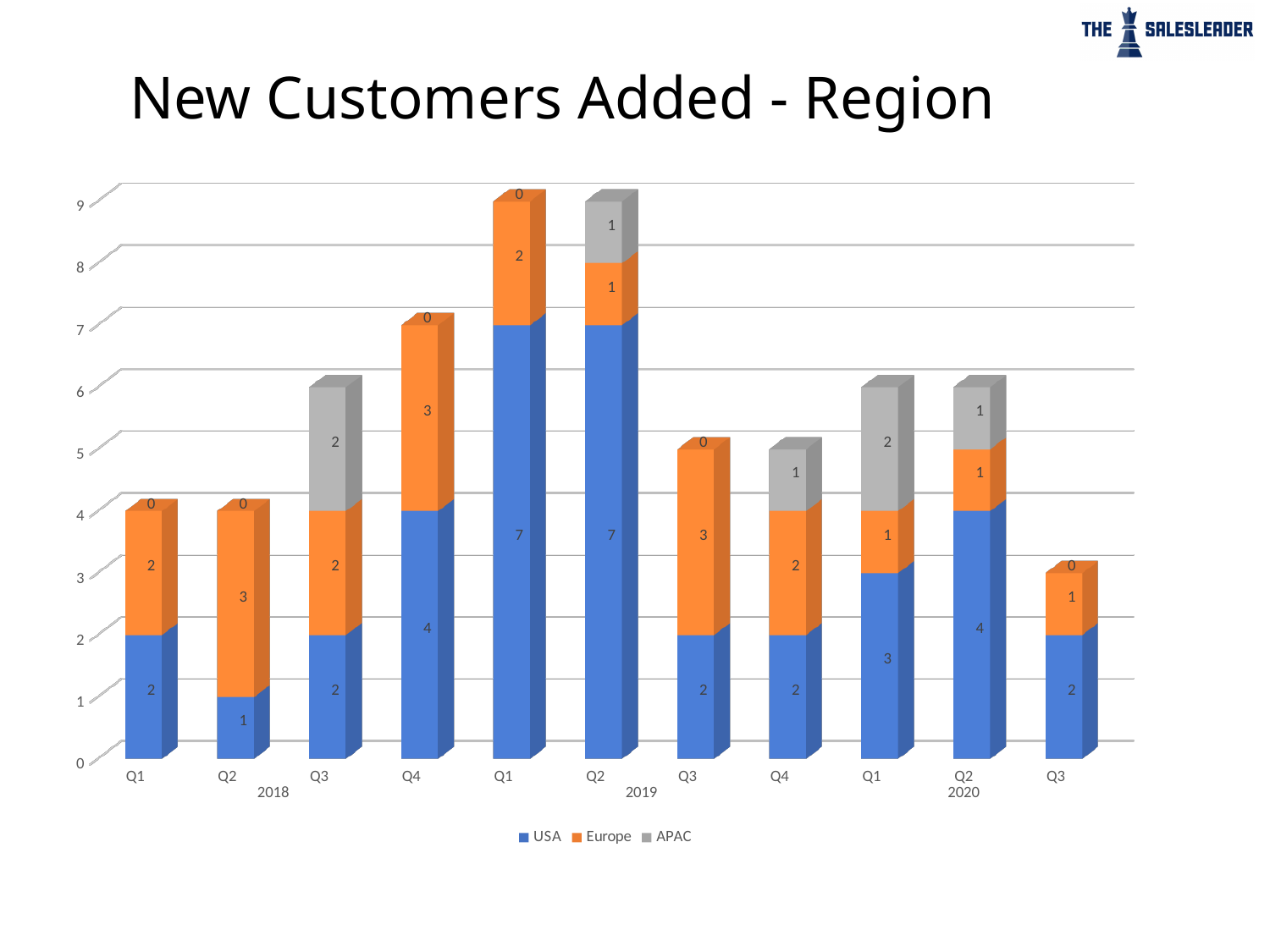
What is the total of the stacked bar for Q3 2020? 3 Which quarter has the lowest total of new customers added? Q3 2020 How many quarters (categories) are plotted on the x axis? 11 What is the difference between the USA value for Q1 2019 and the USA value for Q1 2020? 4 What is the Europe value for Q4 2018? 3 What is the total of the stacked bar for Q2 2019? 9 What is the USA value for Q1 2019? 7 How many series does the legend list? 3 What is the title of the chart? New Customers Added - Region What type of chart is shown on the slide? Stacked bar chart Which is larger, the Europe value for Q2 2018 or the Europe value for Q2 2020? Q2 2018 What is the APAC value for Q1 2020? 2